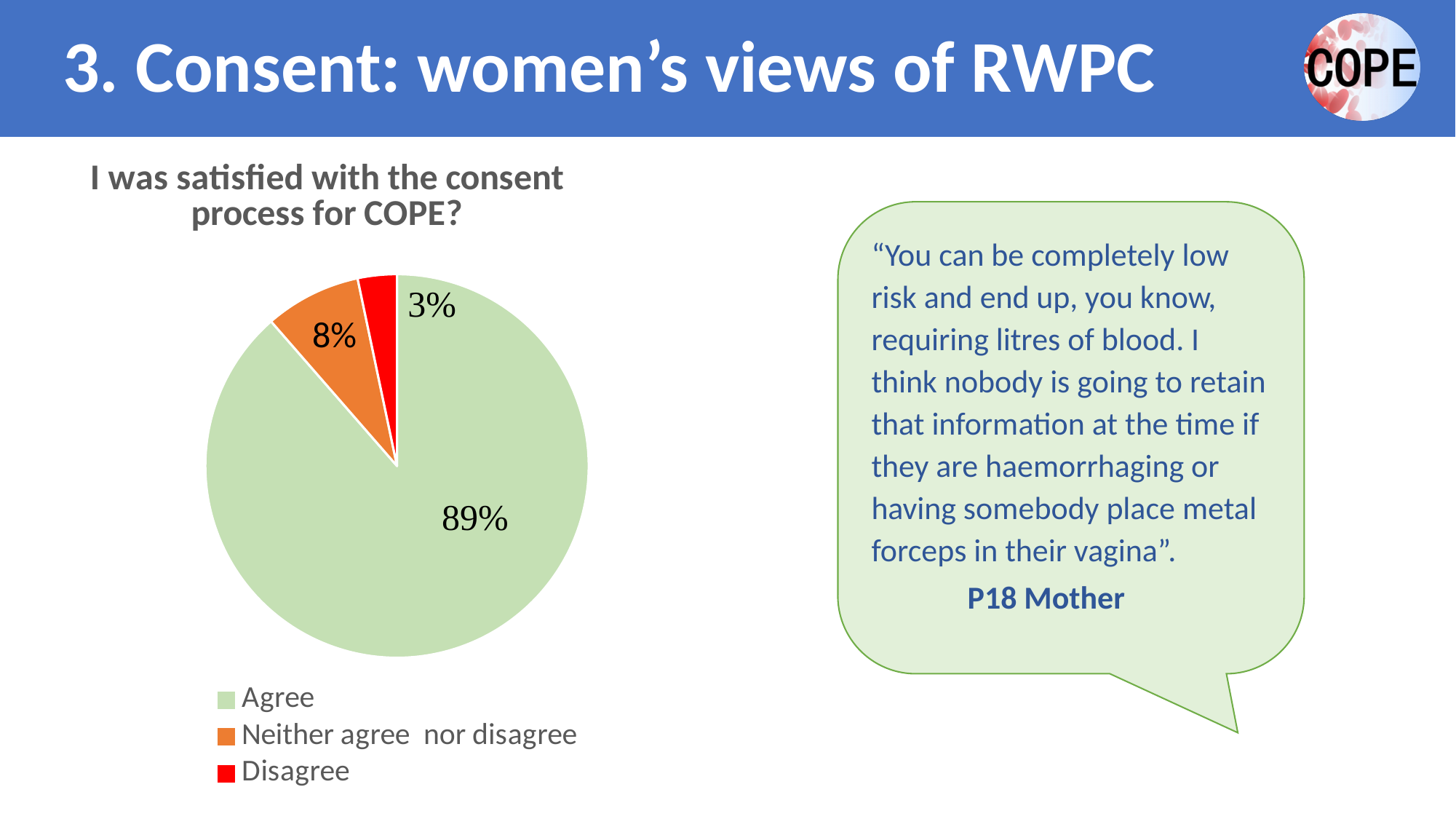
What is the difference in percentage points between Agree and Disagree? 86 What percentage of respondents chose Agree? 89% Which response category has the largest share of the pie? Agree What is the title of the pie chart? I was satisfied with the consent process for COPE? What colour is the Agree slice in the pie chart? green How many categories does the pie chart show? 3 What percentage of respondents chose Disagree? 3% What is the difference in percentage points between Neither agree nor disagree and Disagree? 5 Which response category has the smallest share of the pie? Disagree What percentage of respondents chose Neither agree nor disagree? 8% Which is larger, the share for Neither agree nor disagree or the share for Disagree? Neither agree nor disagree What kind of chart is shown on the slide? pie chart